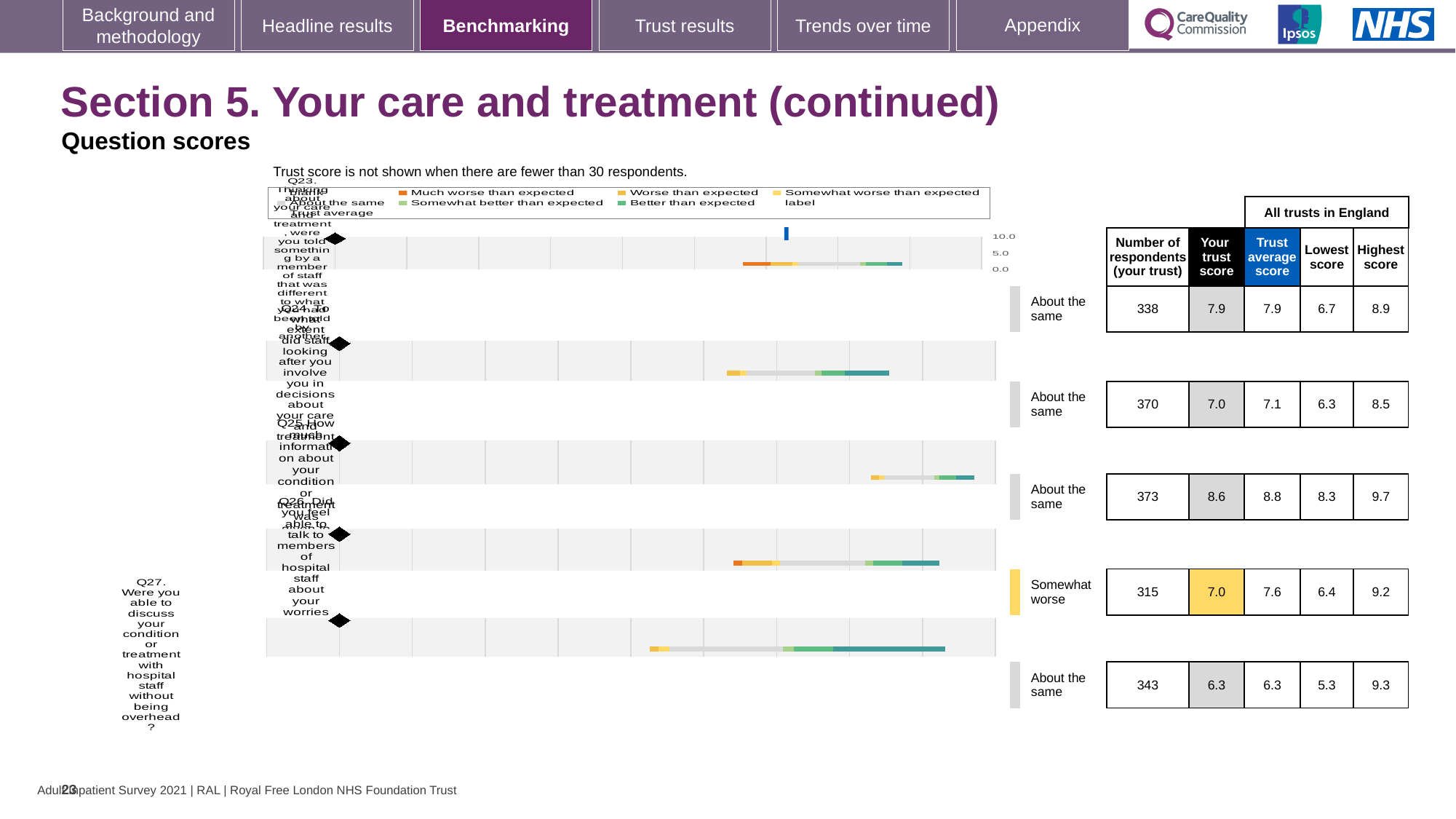
What is the lowest score across all trusts in England for Q24? 6.3 Which question is rated 'Somewhat worse' than expected? Q26 How many respondents from the trust answered Q23? 338 What is the highest score across all trusts in England for Q26? 9.2 How many questions are shown on this slide? 5 Which question has the highest trust score on this slide? Q25 What is the trust score for Q27 (discussing your condition or treatment without being overheard)? 6.3 Which question has the lowest trust score on this slide? Q27 What kind of chart is used to show the question scores? Bar chart What is the trust average score for Q25? 8.8 For Q24, which is larger: the trust's own score or the trust average score? Trust average score For Q26, what is the difference between the trust average score and the trust's own score? 0.6